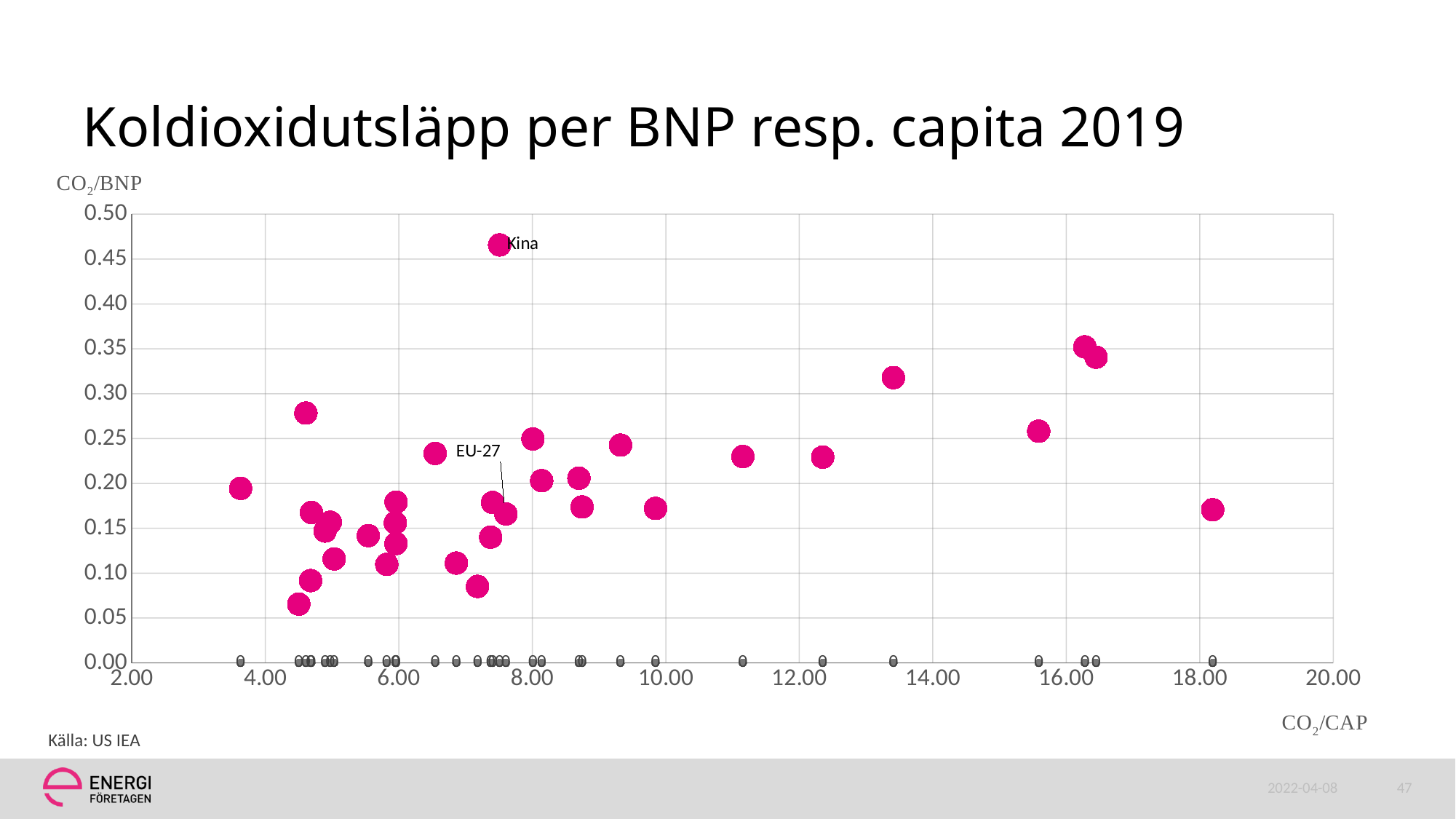
Which labelled point has the highest CO2/BNP value in the chart? Kina Is the CO2/CAP value for Kina greater or less than 8.00? less Which of the two labelled points, Kina or EU-27, has the higher CO2/BNP value? Kina What is the label of the vertical axis? CO2/BNP Is the CO2/BNP value for Kina greater or less than 0.45? greater Is the CO2/BNP value for Kina greater or less than 0.40? greater What is the title of the chart? Koldioxidutsläpp per BNP resp. capita 2019 What kind of chart is shown on the slide? scatter chart